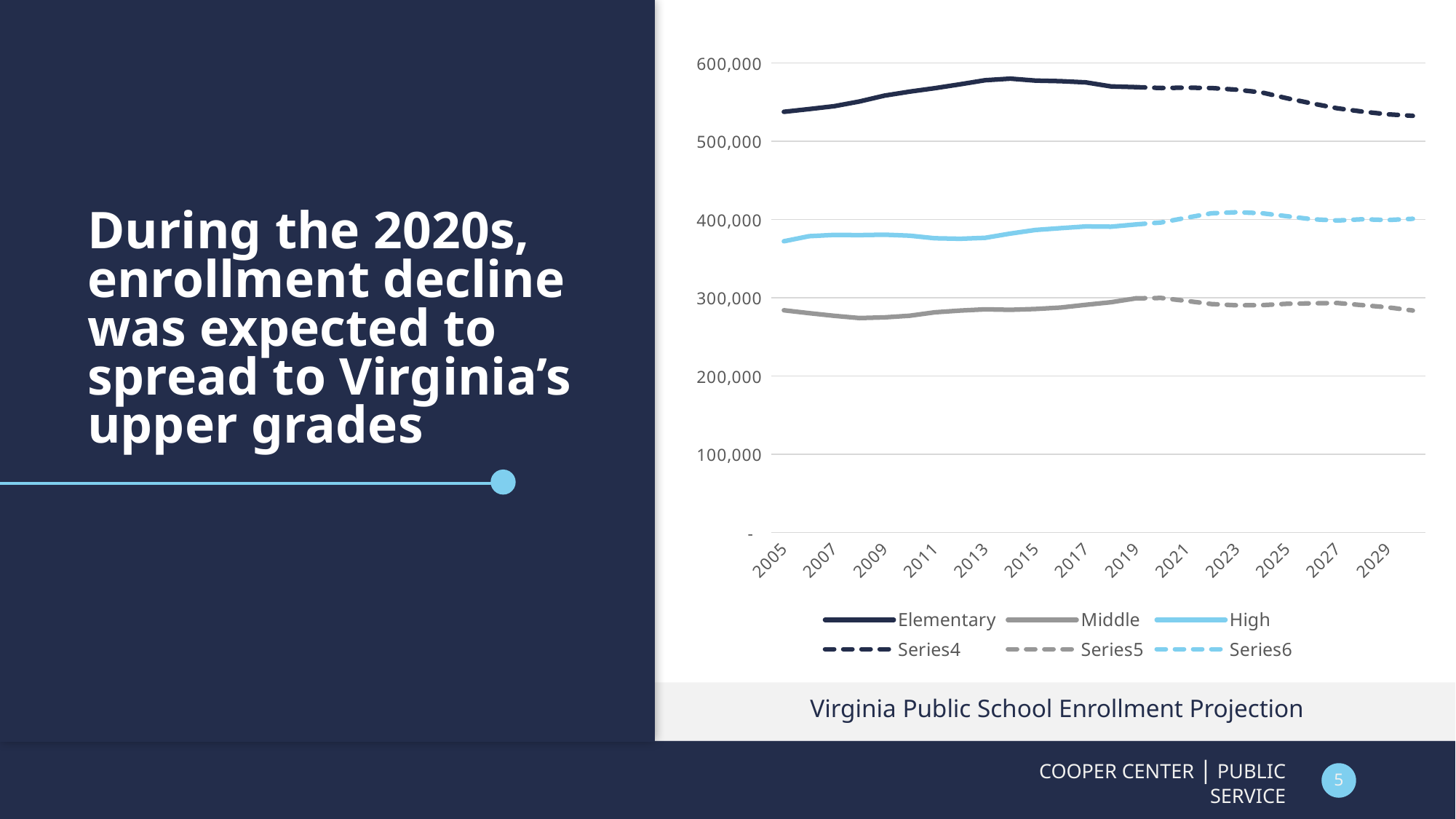
What kind of chart is shown on the slide? line chart Is the value for Middle in 2005 greater or less than 300,000? less Is the value for Elementary in 2005 greater or less than 500,000? greater Is the value for Series5 in 2029 greater or less than 300,000? less How many year labels are shown on the x axis? 13 What is the title shown beneath the chart? Virginia Public School Enrollment Projection How many series does the chart legend list? 6 Does the Series4 line rise or fall from 2021 to 2029? fall In 2005, which is larger, the value for Elementary or the value for High? Elementary